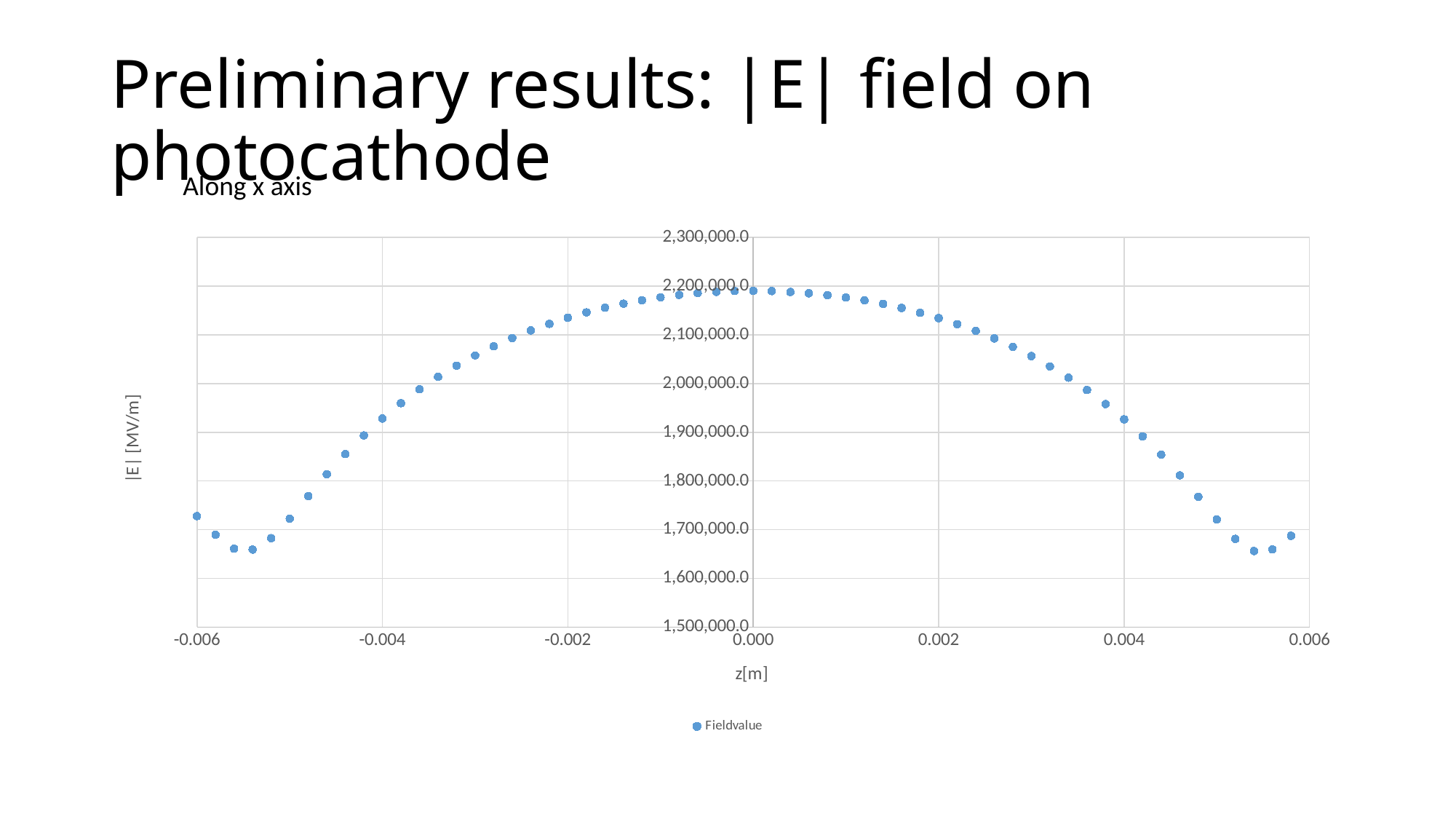
What is the name of the series shown in the legend? Fieldvalue Is the value at z = -0.002 greater or less than 2,100,000.0? greater Is the value at z = 0.004 greater or less than 2,000,000.0? less Is the value at z = -0.006 greater or less than 1,800,000.0? less Which is larger, the value at z = 0.000 or the value at z = 0.004? z = 0.000 Do the values rise or fall as z goes from -0.004 to 0.000? rise What kind of chart is shown on the slide? scatter chart What is the title of the vertical axis? |E| [MV/m] How many series does the legend list? 1 At which labelled x-axis tick is the plotted value highest? 0.000